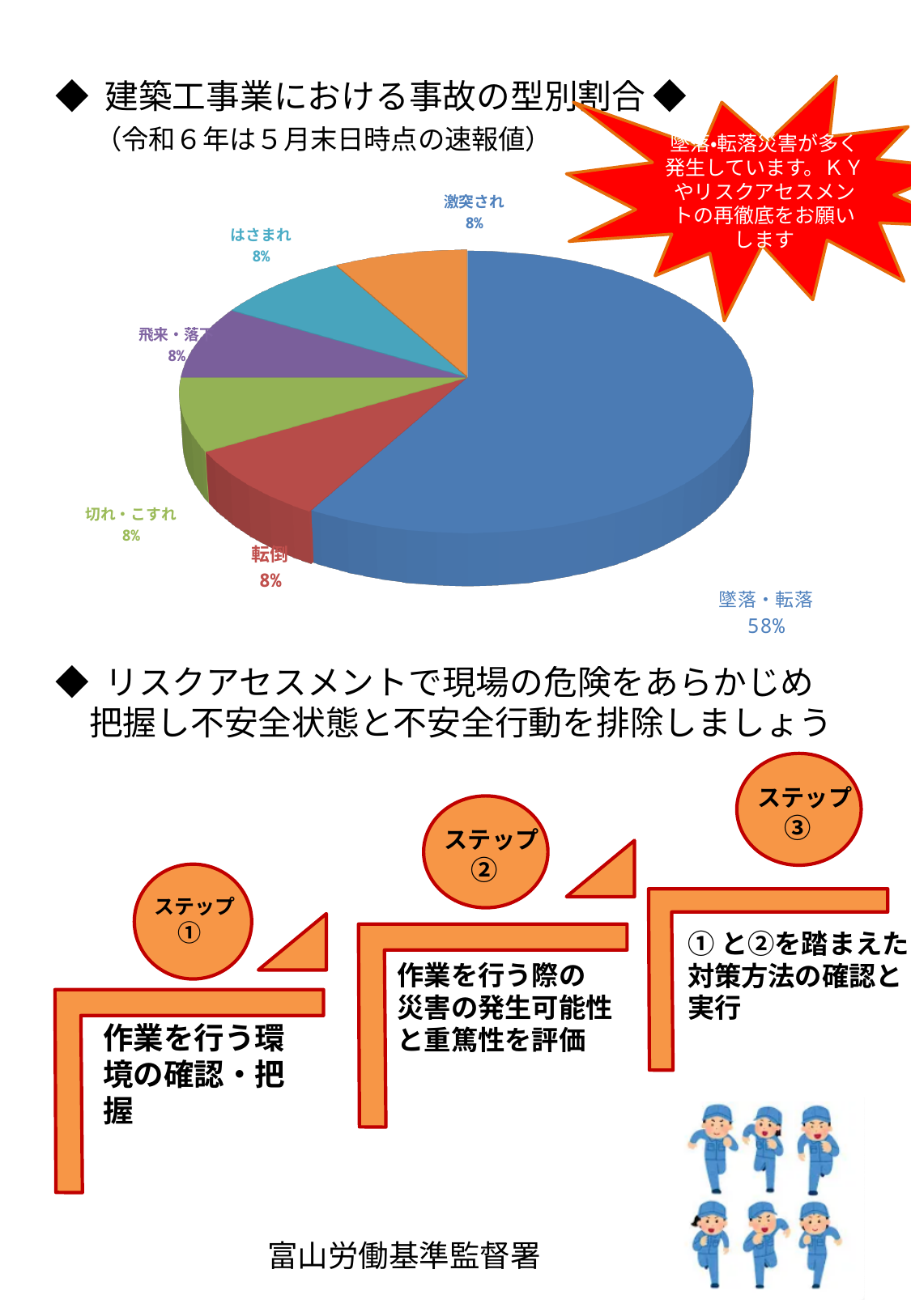
What is the difference in percentage points between 墜落・転落 and 転倒 in the pie chart? 50 percentage points What colour is the largest slice of the pie chart? blue Which accident type has the largest share in the pie chart? 墜落・転落 How many slices does the pie chart have? 6 What percentage is shown for 墜落・転落 in the pie chart? 58% What percentage is shown for 激突され in the pie chart? 8% What percentage is shown for はさまれ in the pie chart? 8% What is the title of the pie chart? 建築工事業における事故の型別割合 Which has the larger share in the pie chart, 墜落・転落 or はさまれ? 墜落・転落 What percentage is shown for 切れ・こすれ in the pie chart? 8% What kind of chart is shown on the slide? pie chart What percentage is shown for 転倒 in the pie chart? 8%